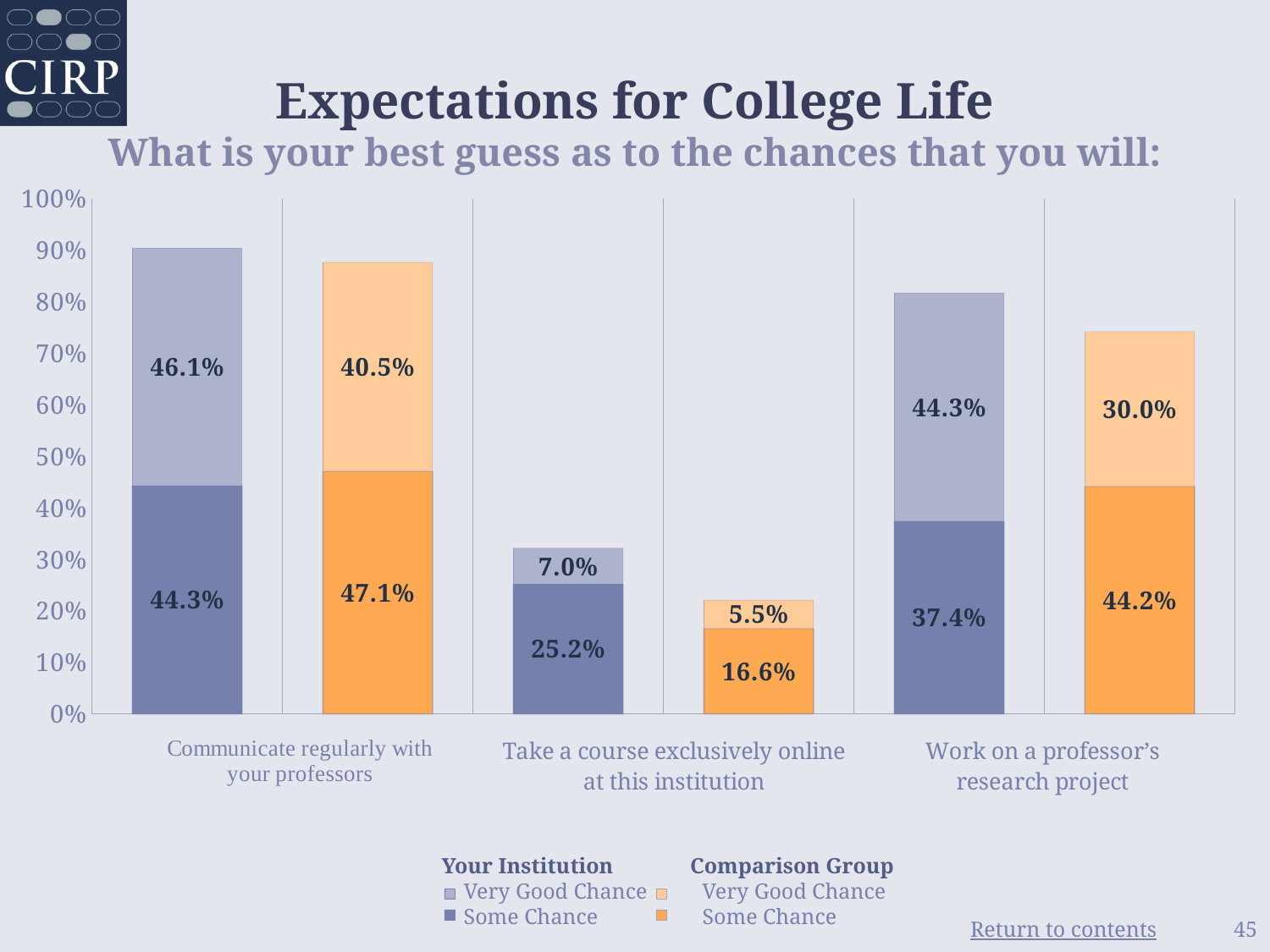
How many series does the legend list? 4 What is the Comparison Group's Some Chance value for taking a course exclusively online at this institution? 16.6% For 'Communicate regularly with your professors', which group has the larger Some Chance value, Your Institution or Comparison Group? Comparison Group What is the total height of the Comparison Group stacked bar for 'Take a course exclusively online at this institution'? 22.1% Which colour represents the Comparison Group's Some Chance series? Orange What type of chart is shown on the slide? Stacked bar chart What percentage of Your Institution students said there is a Very Good Chance they will communicate regularly with their professors? 46.1% What is the Your Institution Some Chance value for working on a professor's research project? 37.4% What is the total height of the Your Institution stacked bar for 'Communicate regularly with your professors'? 90.4% How many categories are shown along the x axis of the chart? 3 Which category has the lowest Very Good Chance value for Your Institution? Take a course exclusively online at this institution What is the difference between the Your Institution and Comparison Group Very Good Chance values for working on a professor's research project? 14.3%